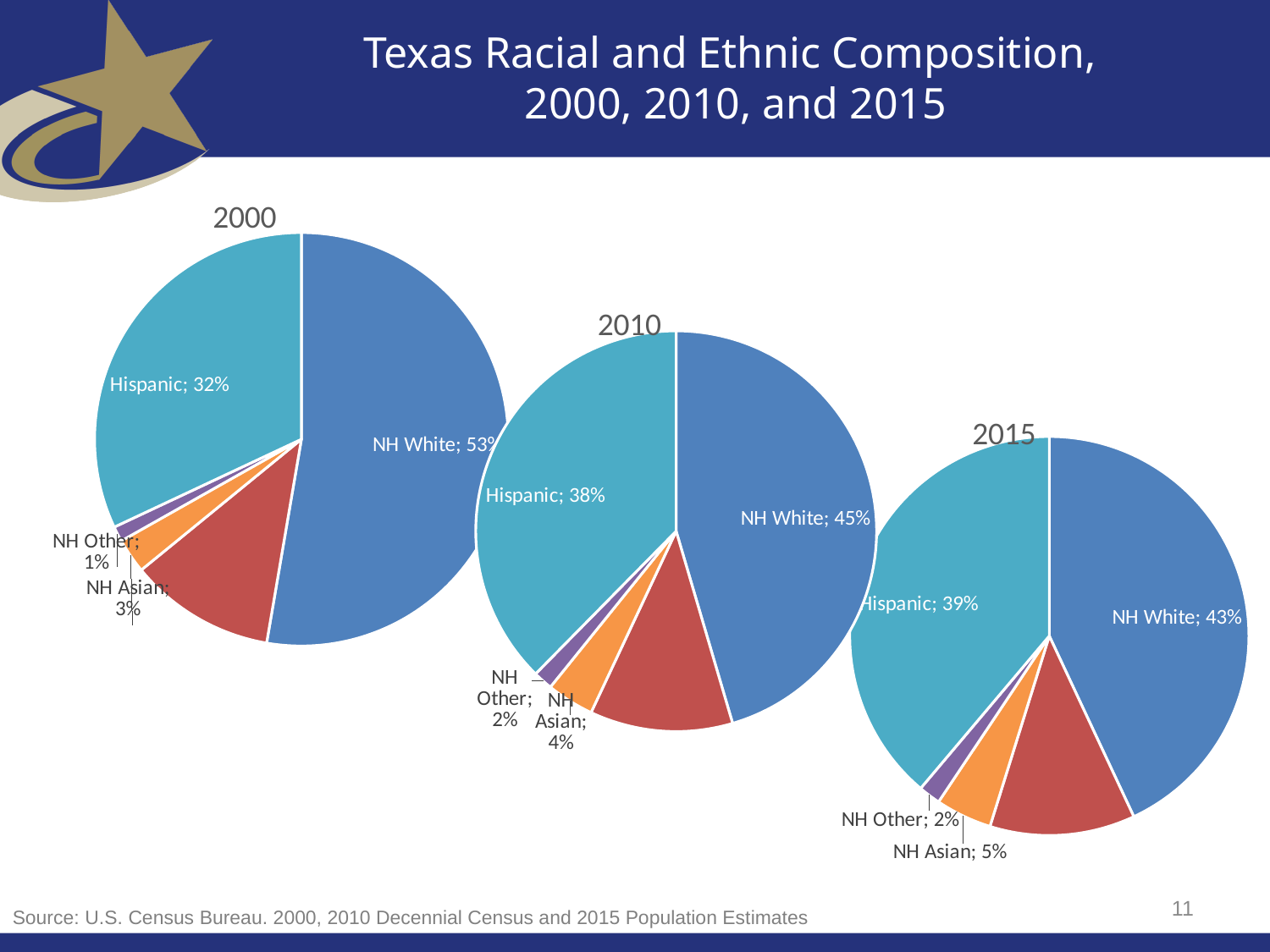
In the 2010 pie chart, what share of the population is Hispanic? 38% In the 2000 pie chart, what share of the population is NH Other? 1% In the 2000 pie chart, how many percentage points larger is the NH White share than the Hispanic share? 21 percentage points In the 2015 pie chart, which is larger, the NH White share or the Hispanic share? NH White In the 2015 pie chart, what share of the population is NH Asian? 5% In the 2000 pie chart, what share of the population is NH White? 53% In the 2015 pie chart, which labeled group has the largest share? NH White Across the 2000, 2010, and 2015 pie charts, does the NH White share rise or fall over time? Fall How many slices does the 2010 pie chart have? 5 How many pie charts are shown on the slide? 3 In the 2010 pie chart, which labeled group has the smallest share? NH Other What kind of chart is used for the 2000 data on the slide? Pie chart